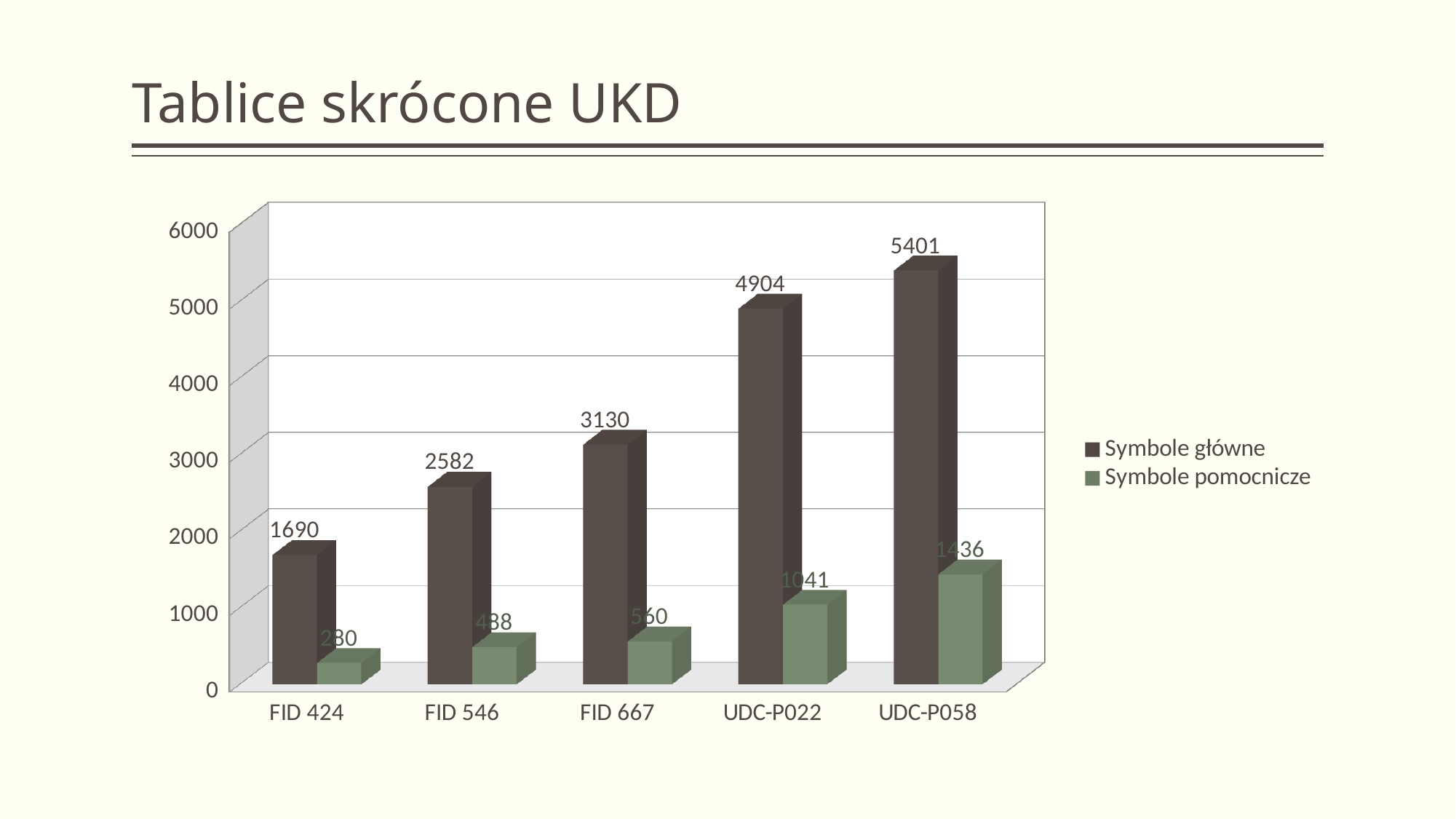
Is the value of Symbole główne for FID 424 greater or less than 2000? less Which category has the highest value for Symbole główne? UDC-P058 What is the value of Symbole pomocnicze for UDC-P022? 1041 What is the difference between the Symbole główne values for UDC-P058 and UDC-P022? 497 How many categories are shown on the x axis? 5 What kind of chart is shown on the slide? bar chart Which category has the lowest value for Symbole pomocnicze? FID 424 How many series does the legend list? 2 What is the value of Symbole pomocnicze for UDC-P058? 1436 What is the value of Symbole główne for UDC-P058? 5401 Which is larger: Symbole główne for FID 667 or Symbole główne for FID 546? FID 667 What is the value of Symbole główne for FID 546? 2582